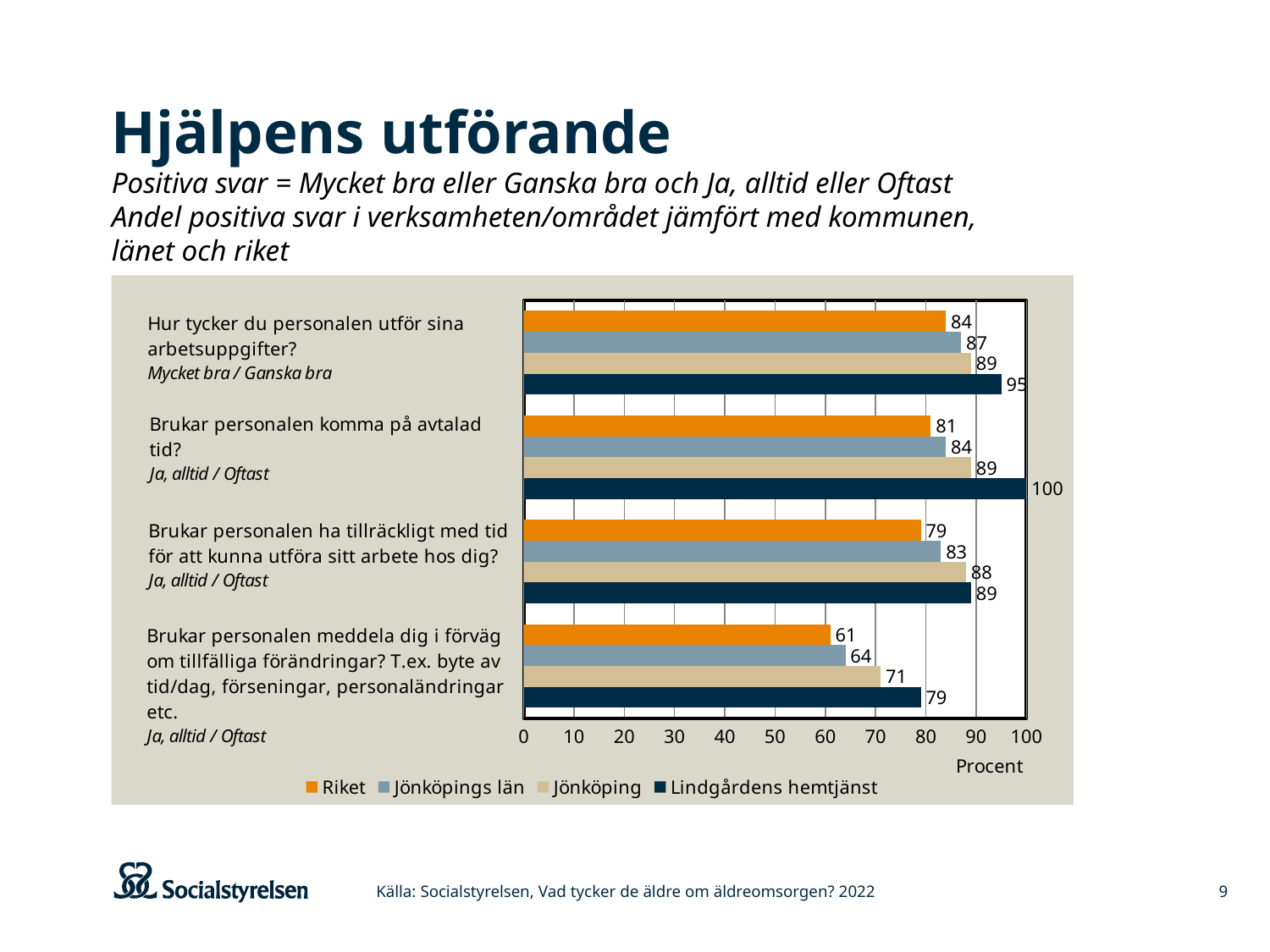
What value is shown for Lindgårdens hemtjänst on the question 'Brukar personalen komma på avtalad tid?' 100 What is the label on the horizontal axis of the chart? Procent How many questions (categories) are shown on the chart? 4 Which series has the lowest value on the question 'Brukar personalen meddela dig i förväg om tillfälliga förändringar?' Riket What is the difference between Lindgårdens hemtjänst and Riket on the question 'Brukar personalen meddela dig i förväg om tillfälliga förändringar?' 18 What value is shown for Jönköping on the question 'Brukar personalen ha tillräckligt med tid för att kunna utföra sitt arbete hos dig?' 88 What value is shown for Riket on the question 'Brukar personalen meddela dig i förväg om tillfälliga förändringar?' 61 What value is shown for Jönköpings län on the question 'Hur tycker du personalen utför sina arbetsuppgifter?' 87 Which is larger on the question 'Brukar personalen komma på avtalad tid?': Jönköping or Jönköpings län? Jönköping Which series has the highest value on the question 'Hur tycker du personalen utför sina arbetsuppgifter?' Lindgårdens hemtjänst How many series does the legend list? 4 What kind of chart is shown on the slide? Bar chart